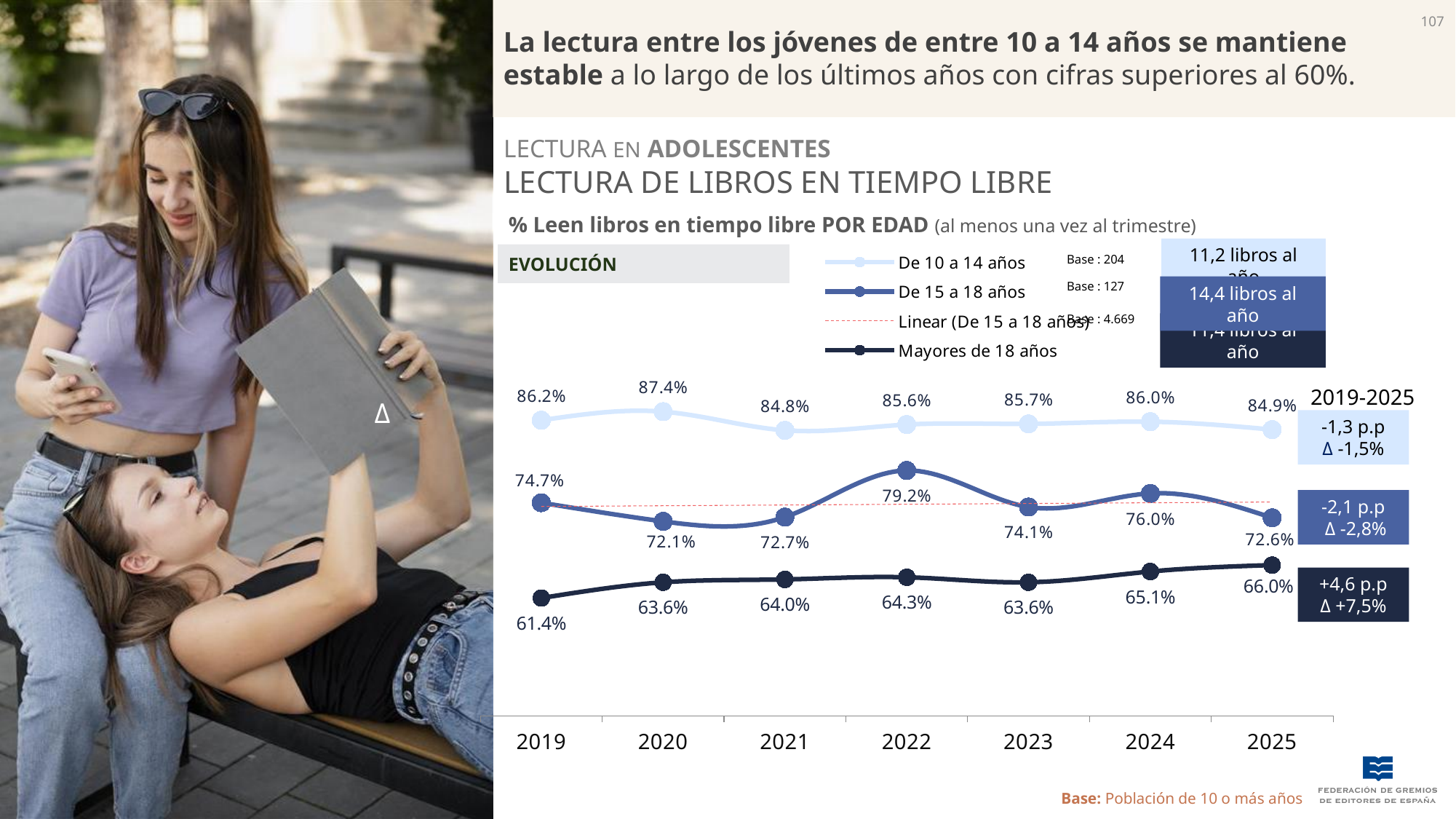
Does the value for 'Mayores de 18 años' generally rise or fall from 2019 to 2025? rise In which year is the value for 'De 15 a 18 años' highest? 2022 Which is larger in 2023: the value for 'De 15 a 18 años' or the value for 'Mayores de 18 años'? De 15 a 18 años What is the value for 'Mayores de 18 años' in 2019? 61.4% What is the value for 'De 15 a 18 años' in 2022? 79.2% In which year is the value for 'Mayores de 18 años' lowest? 2019 What is the value for 'De 10 a 14 años' in 2020? 87.4% What is the difference between the 'De 10 a 14 años' value and the 'Mayores de 18 años' value in 2025? 18.9 percentage points What change in percentage points is shown for 'De 15 a 18 años' over 2019-2025? -2,1 p.p How many years are shown on the x axis? 7 What type of chart is shown on the slide? line chart How many entries does the legend list? 4